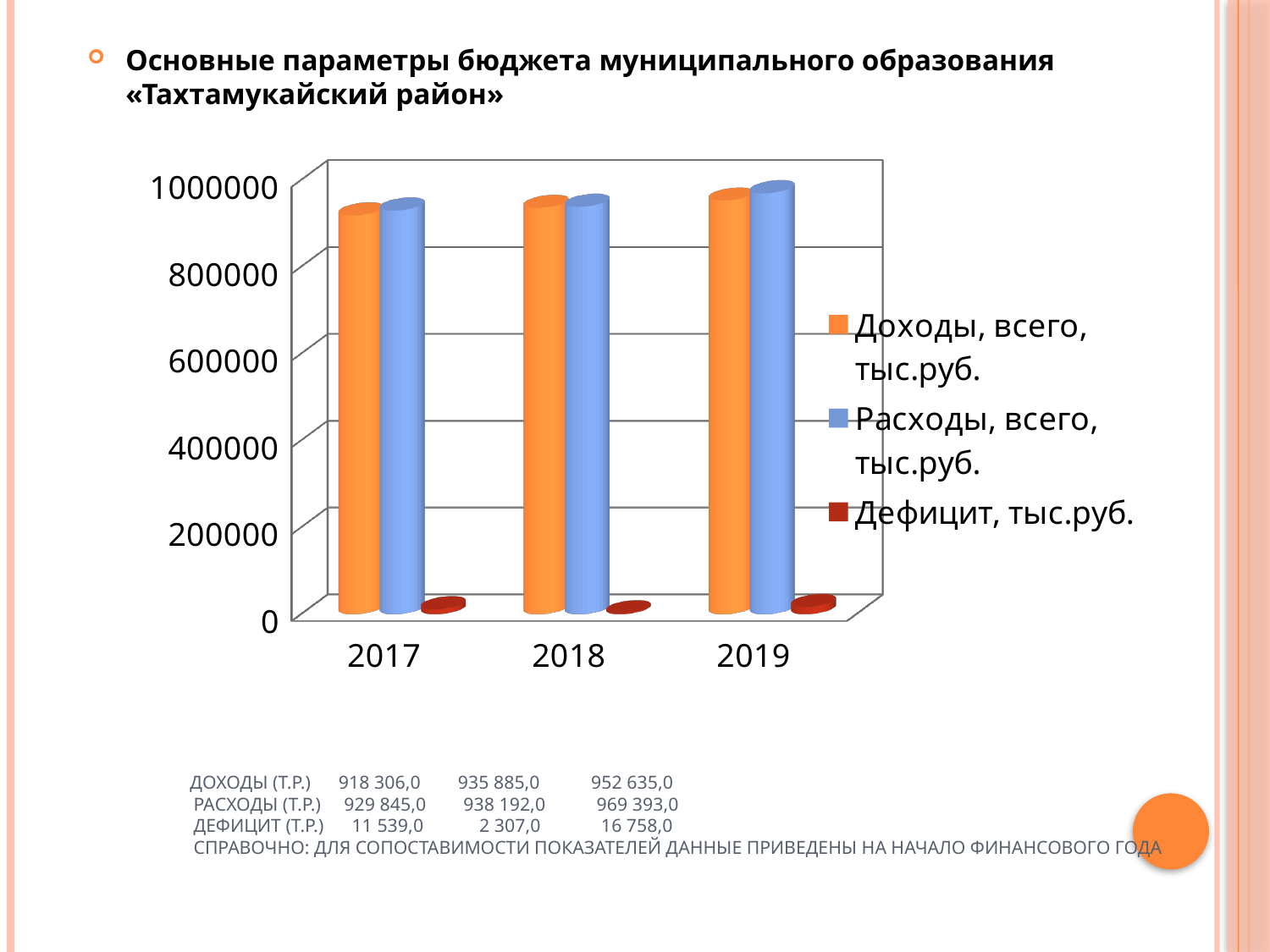
According to the figures printed below the chart, what is the value of Расходы for 2018? 938 192,0 What kind of chart is shown on the slide? bar chart Which series has the lowest values in every year of the chart? Дефицит, тыс.руб. Is the value of Дефицит for 2019 greater or less than 200000? less Do the Доходы values rise or fall from 2017 to 2019? rise According to the figures printed below the chart, what is the value of Дефицит for 2017? 11 539,0 Is the value of Доходы for 2017 greater or less than 800000? greater How many years are shown on the x axis of the chart? 3 Which series is shown in orange in the chart legend? Доходы, всего, тыс.руб. According to the figures printed below the chart, what is the value of Доходы for 2019? 952 635,0 How many series does the chart legend list? 3 According to the figures printed below the chart, in which year is Дефицит the lowest? 2018